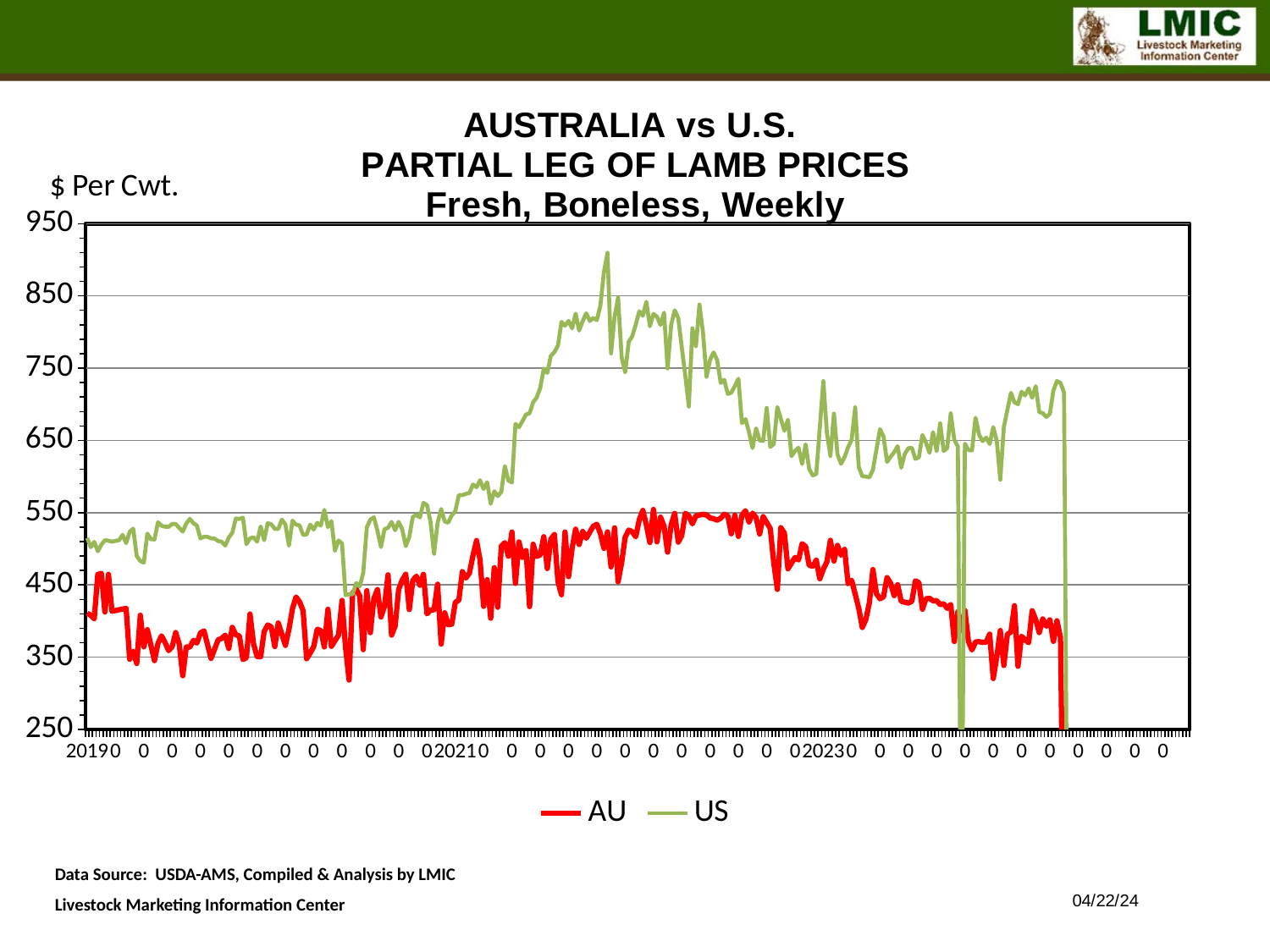
What is the highest value shown on the vertical axis? 950 Does the US series rise or fall from the start of the chart to its peak in 2022? rise Does the AU series rise or fall from its 2022 level to the end of the chart? fall Is the value of the AU series at the start of the chart (2019) greater or less than 550? less Is the highest value reached by the US series greater or less than 850? greater Is the highest value reached by the AU series greater or less than 650? less What kind of chart is shown on the slide? line chart Which series is drawn with the red line? AU Which series, AU or US, has the higher prices across the chart? US How many series does the legend list? 2 What are the two series named in the legend? AU and US